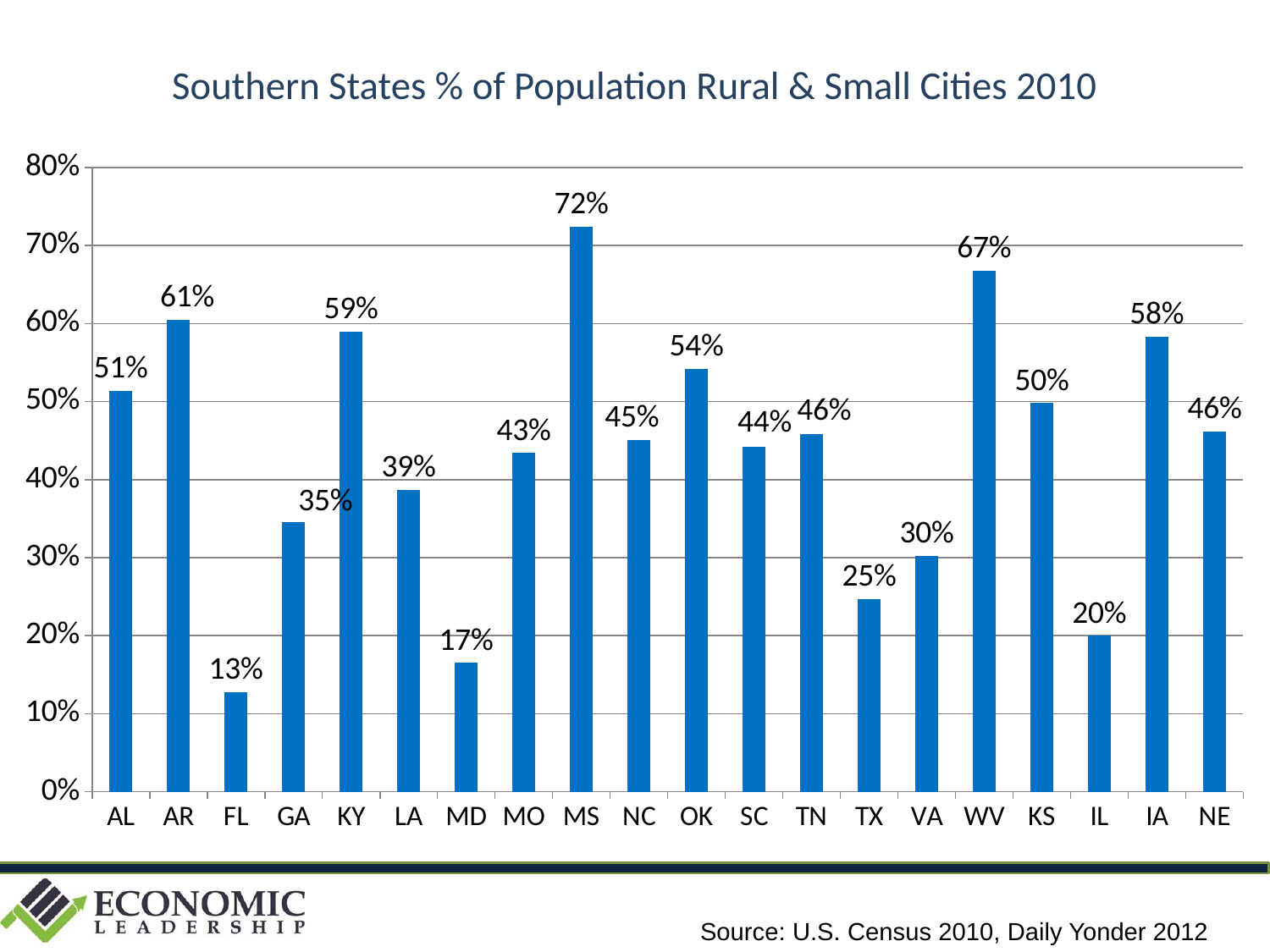
Which is larger, the value for TX or the value for VA? VA Which state has the highest value? MS Which state has the lowest value? FL What is the difference between the values for AR and KY? 2% What is the title of the chart? Southern States % of Population Rural & Small Cities 2010 What is the value for FL? 13% What is the value for MS? 72% How many states are shown on the x axis? 20 What kind of chart is shown on the slide? bar chart What is the value for WV? 67% Is the value for IA greater or less than 50%? greater What is the difference between the values for MS and FL? 59%